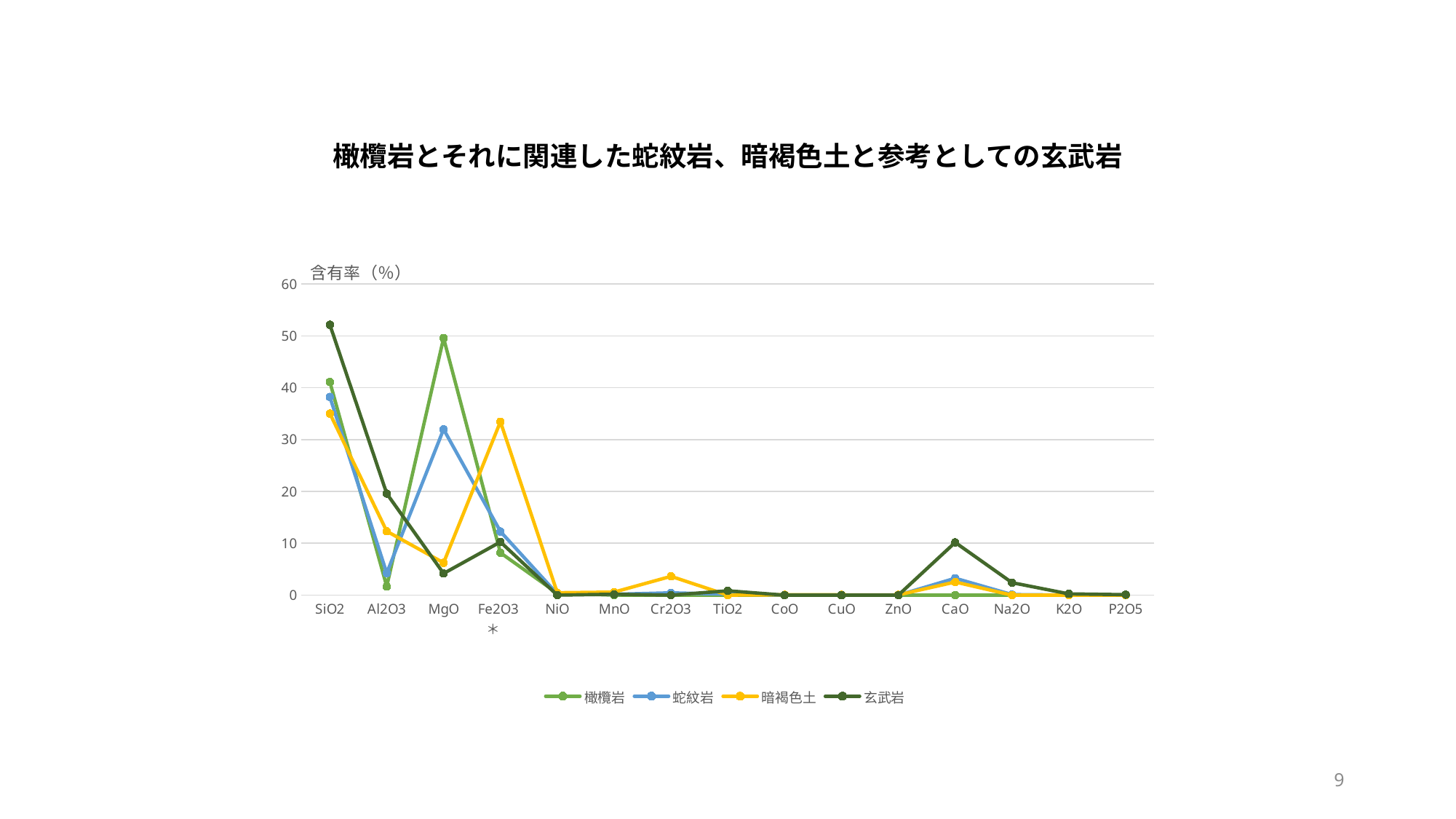
Does the 玄武岩 series rise or fall from SiO2 to Al2O3? fall How many series does the legend list? 4 Which series has the highest value at SiO2? 玄武岩 Is the value for 橄欖岩 at MgO greater or less than 40? greater For the 玄武岩 series, which category has the highest value? SiO2 At CaO, which is larger: 玄武岩 or 蛇紋岩? 玄武岩 For the 橄欖岩 series, which category has the highest value? MgO What is the label shown on the y axis? 含有率（%） At Al2O3, which is larger: 玄武岩 or 暗褐色土? 玄武岩 What kind of chart is shown on the slide? line chart How many categories are shown along the x axis? 15 Is the value for 蛇紋岩 at MgO greater or less than 20? greater